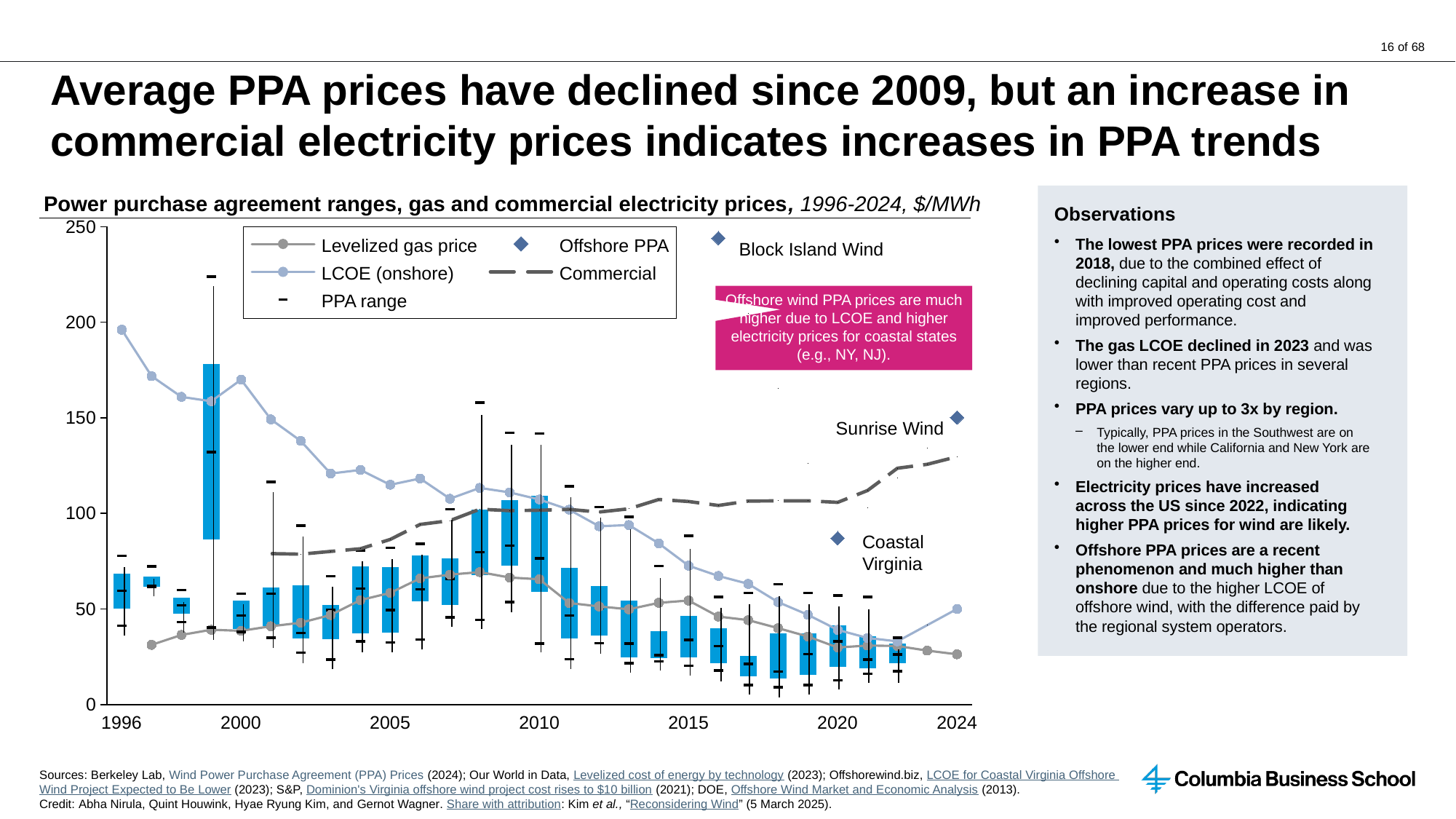
Is the Offshore PPA value for Coastal Virginia greater or less than 100? less Does the LCOE (onshore) line rise or fall between 1996 and 2020? fall Which labeled Offshore PPA project has the lowest price? Coastal Virginia Is the Offshore PPA value for Block Island Wind greater or less than 200? greater What unit is used on the chart's value axis, as stated in the chart title? $/MWh Which labeled Offshore PPA project has the highest price? Block Island Wind Is the LCOE (onshore) value in 1996 greater or less than 150? greater What is the maximum value shown on the chart's vertical axis? 250 How many series does the chart legend list? 5